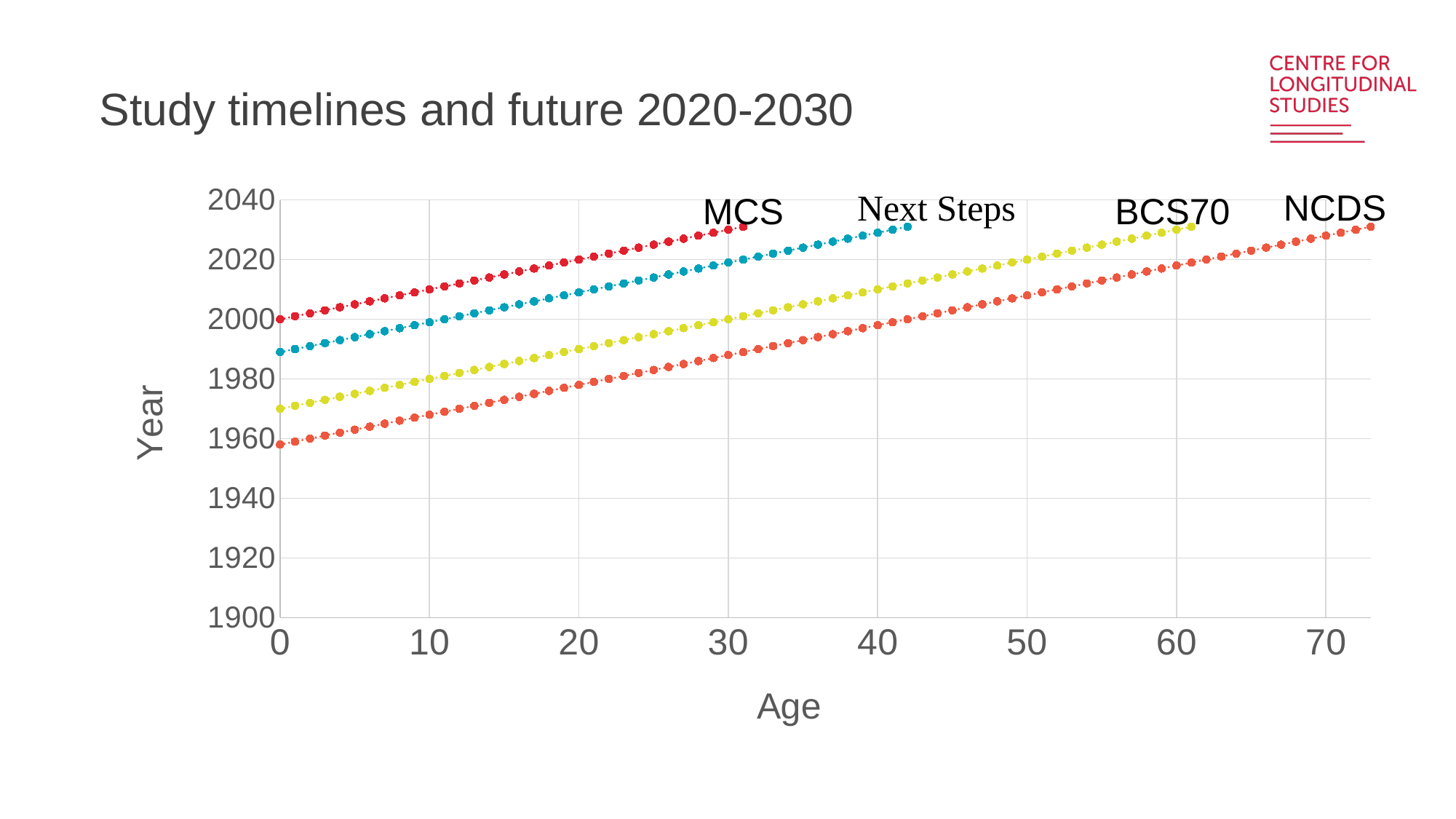
What is the title of the chart slide? Study timelines and future 2020-2030 How many study series are plotted on the chart? 4 What kind of chart is shown on the slide? scatter chart Do the year values rise or fall as age increases along the x axis? rise Which study series starts at the earliest year at age 0? NCDS What is the label of the x axis? Age Is the year for Next Steps at age 0 greater or less than 2000? less What year does the BCS70 series show at age 50? 2020 What year does the MCS series show at age 0? 2000 Which study series extends to the highest age on the chart? NCDS Which study series starts at the latest year at age 0? MCS